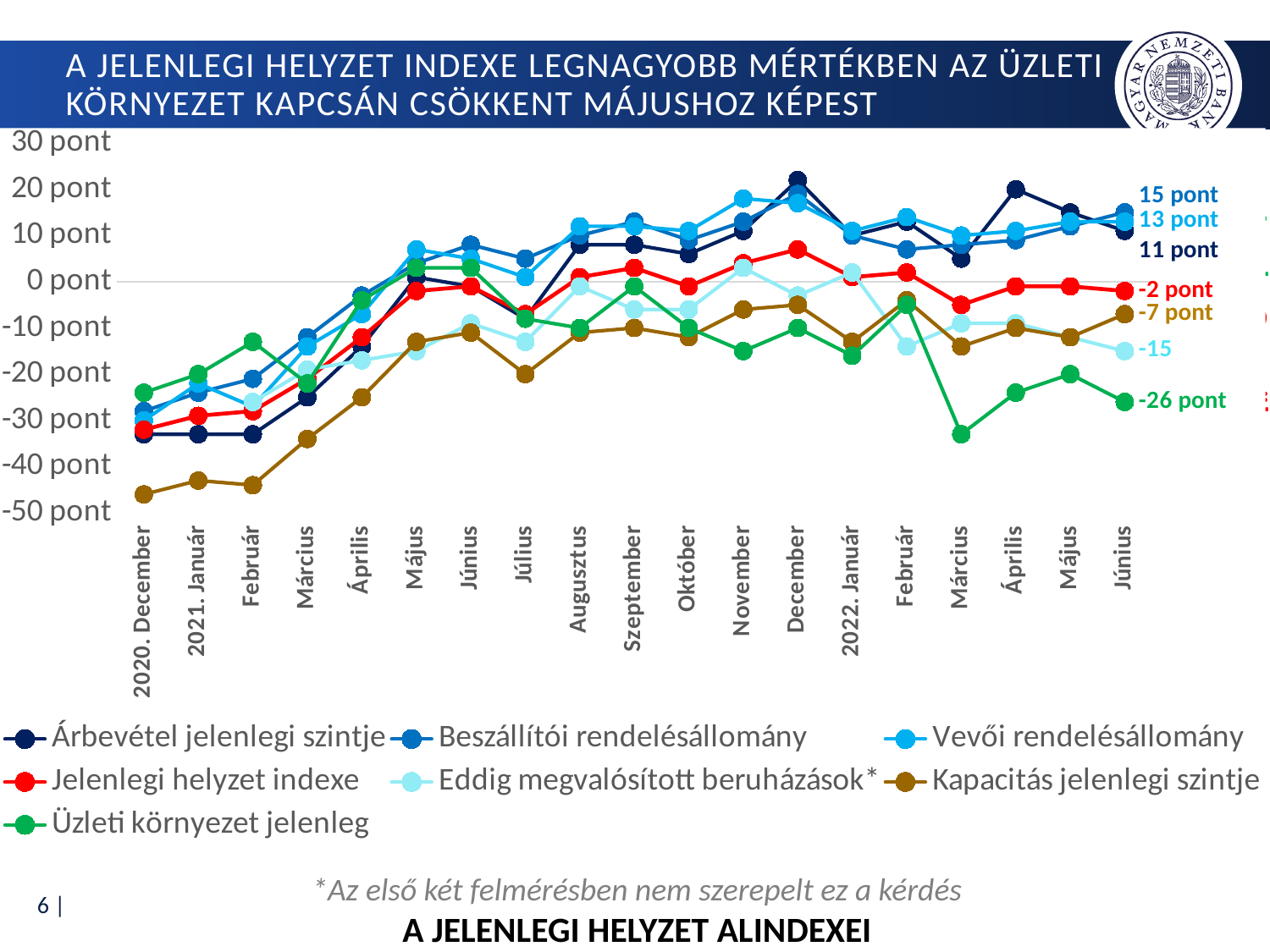
How many months are shown along the x axis? 19 What is the value of Beszállítói rendelésállomány in 2022 Június? 15 pont Which series has the lowest value in 2022 Június? Üzleti környezet jelenleg What is the value of Kapacitás jelenlegi szintje in 2022 Június? -7 pont What is the value of Üzleti környezet jelenleg in 2022 Június? -26 pont Is the value for Kapacitás jelenlegi szintje in 2020. December greater or less than -40 pont? less Which series has the highest value in 2022 Június? Beszállítói rendelésállomány What kind of chart is shown on the slide? line chart What is the difference between Beszállítói rendelésállomány and Vevői rendelésállomány in 2022 Június? 2 pont What is the value of Jelenlegi helyzet indexe in 2022 Június? -2 pont What is the title printed below the chart? A JELENLEGI HELYZET ALINDEXEI How many series does the legend list? 7